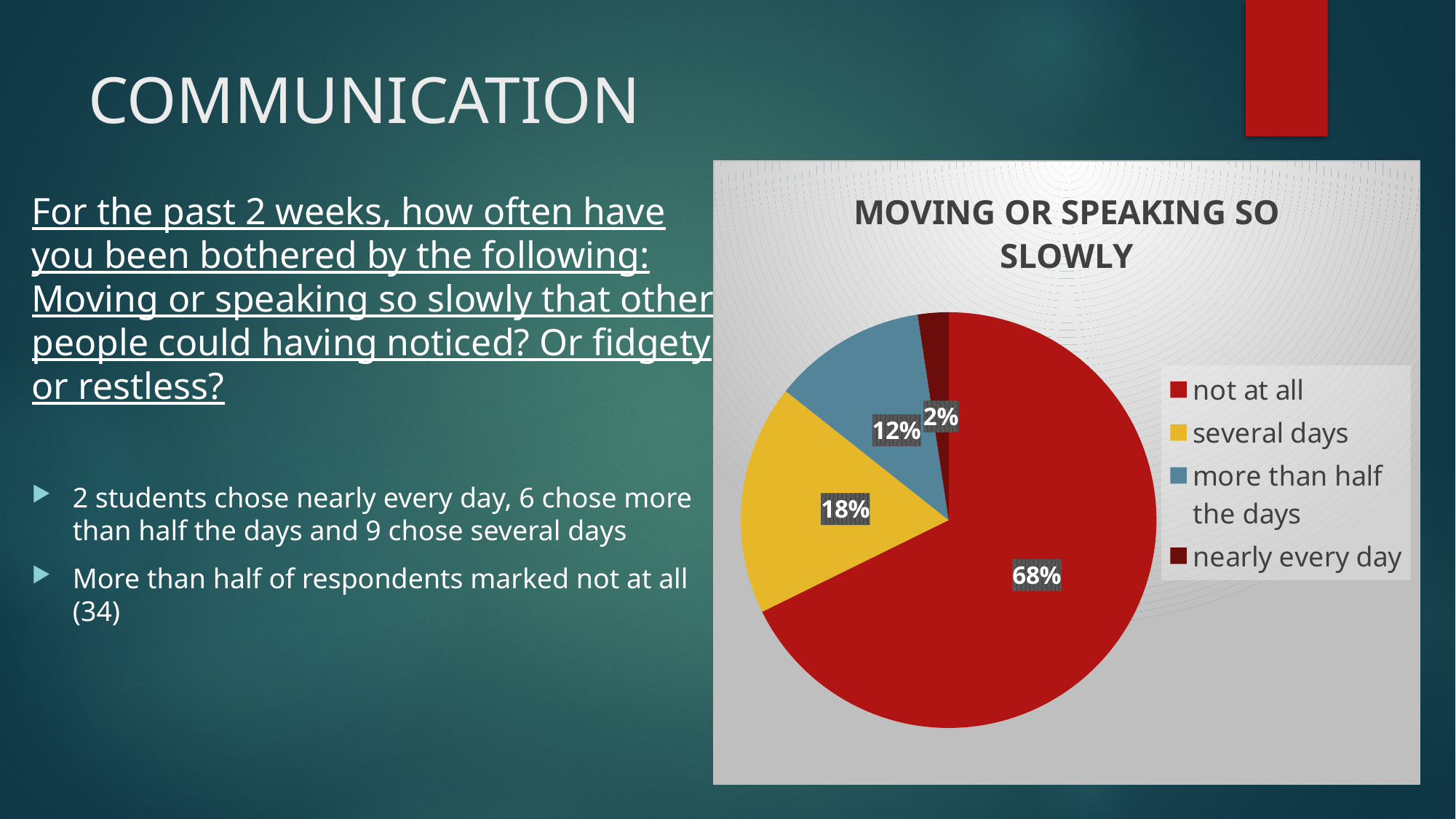
What is the title of the chart? MOVING OR SPEAKING SO SLOWLY What is the difference in percentage points between 'several days' and 'more than half the days'? 6 What percentage of the pie is labelled 'more than half the days'? 12% What kind of chart is shown on the slide? pie chart What colour is the slice for 'several days'? yellow What percentage of the pie is labelled 'several days'? 18% Which is larger, the slice for 'several days' or the slice for 'more than half the days'? several days What percentage of the pie is labelled 'nearly every day'? 2% How many categories does the legend list? 4 Which category has the largest slice of the pie? not at all Which category has the smallest slice of the pie? nearly every day What percentage of the pie is labelled 'not at all'? 68%